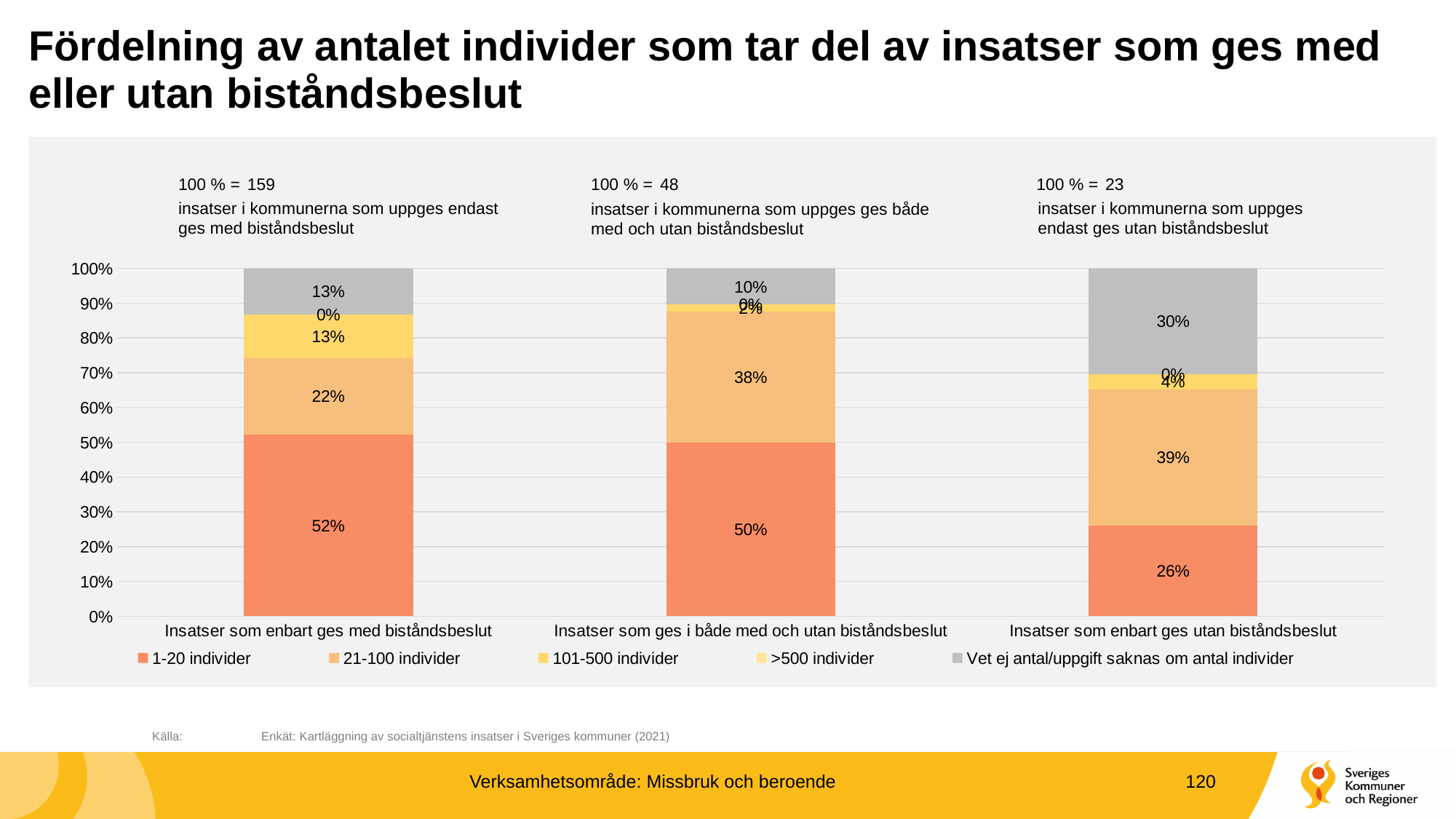
What is the value for '101-500 individer' in the category 'Insatser som enbart ges utan biståndsbeslut'? 4% What is the value for '21-100 individer' in the category 'Insatser som ges i både med och utan biståndsbeslut'? 38% According to the text above the chart, how many insatser does 100 % correspond to for the category 'Insatser som enbart ges med biståndsbeslut'? 159 Which is larger in the category 'Insatser som enbart ges utan biståndsbeslut': the value for '1-20 individer' or for '21-100 individer'? 21-100 individer How many categories are shown on the x axis of the chart? 3 What kind of chart is shown on the slide? Stacked bar chart Which category has the lowest value for 'Vet ej antal/uppgift saknas om antal individer'? Insatser som ges i både med och utan biståndsbeslut How many series does the legend list? 5 Which category has the highest value for '1-20 individer'? Insatser som enbart ges med biståndsbeslut What is the difference between the '1-20 individer' values for 'Insatser som enbart ges med biståndsbeslut' and 'Insatser som enbart ges utan biståndsbeslut'? 26% What is the value for 'Vet ej antal/uppgift saknas om antal individer' in the category 'Insatser som enbart ges utan biståndsbeslut'? 30% What is the value for '1-20 individer' in the category 'Insatser som enbart ges med biståndsbeslut'? 52%